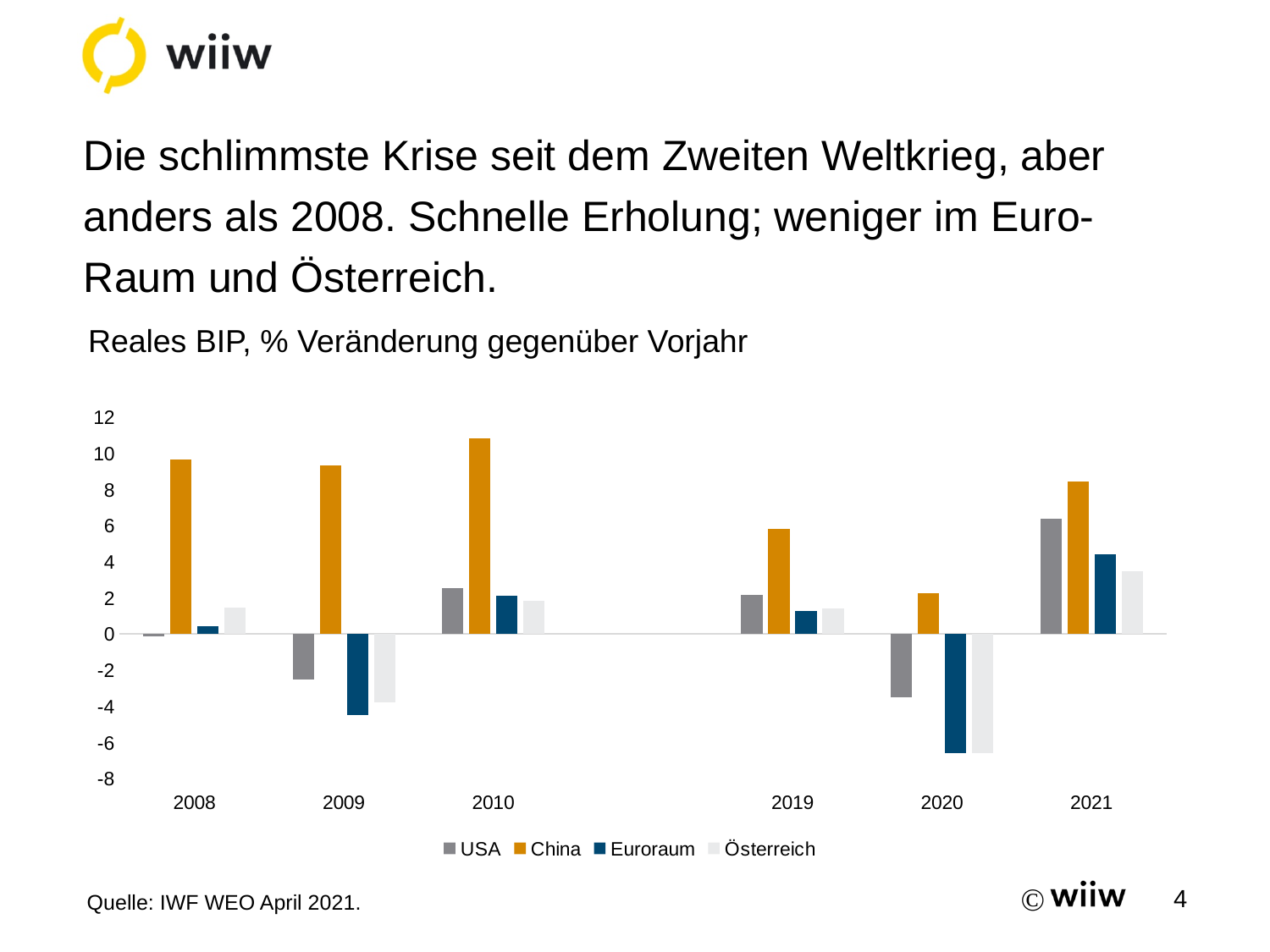
Is the value for China in 2010 greater or less than 10? greater Is the value for USA in 2021 greater or less than 4? greater In which year is the value for USA the lowest? 2020 In which year is the value for China the highest? 2010 Is the value for Euroraum in 2020 greater or less than -6? less What kind of chart is shown on the slide? bar chart In 2009, which is lower: the value for Euroraum or the value for Österreich? Euroraum How many series does the legend list? 4 What is the subtitle describing the chart's measure? Reales BIP, % Veränderung gegenüber Vorjahr How many years are shown on the x axis? 6 Which series is the only one with a positive value in 2020? China In 2021, which is larger: the value for USA or the value for China? China